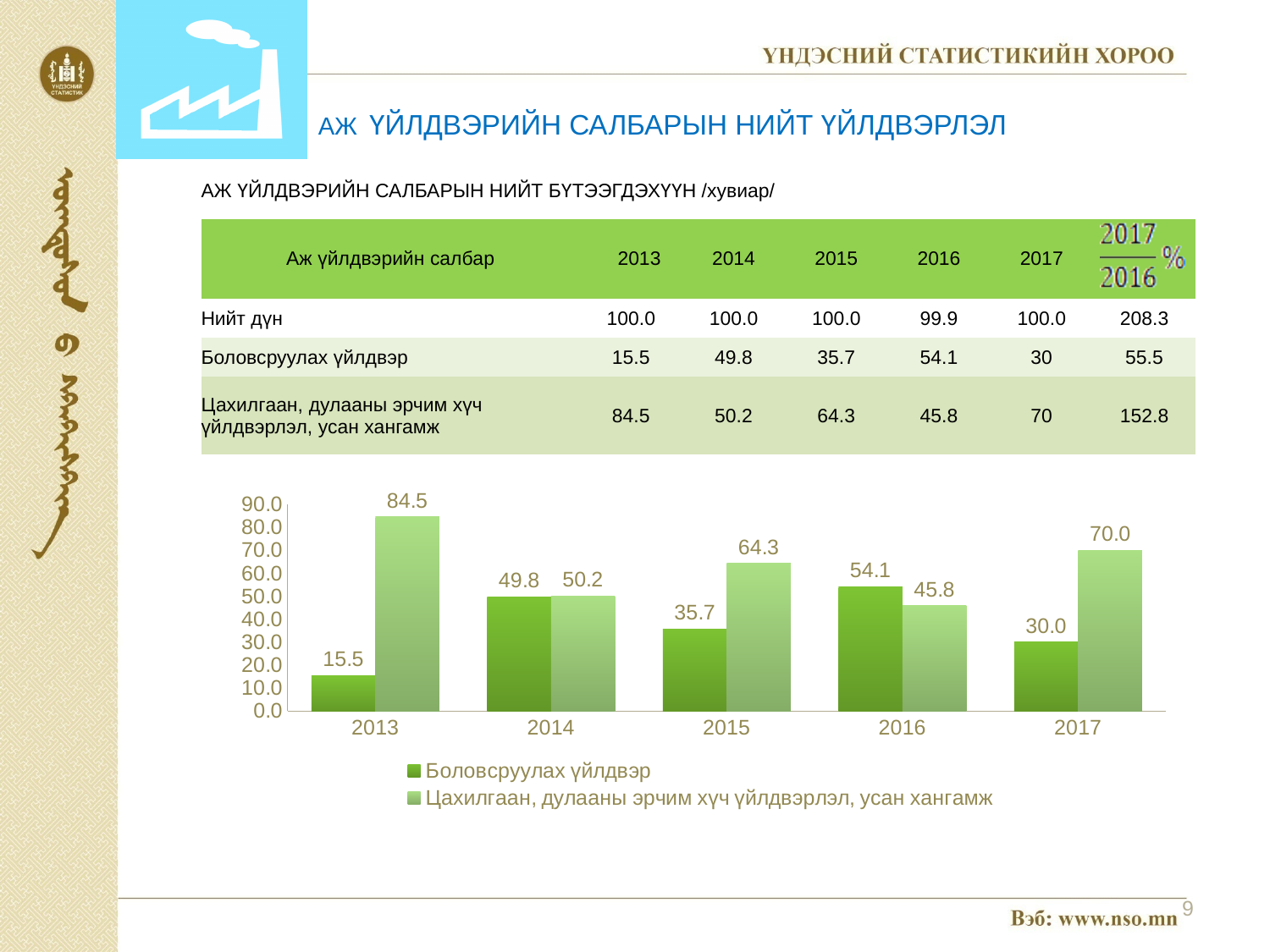
How many series does the chart legend list? 2 How many years are shown on the x axis of the chart? 5 In 2016, which series has the larger value? Боловсруулах үйлдвэр In which year is the value for Цахилгаан, дулааны эрчим хүч үйлдвэрлэл, усан хангамж lowest? 2016 What is the value for Цахилгаан, дулааны эрчим хүч үйлдвэрлэл, усан хангамж in 2015? 64.3 Is the value for Цахилгаан, дулааны эрчим хүч үйлдвэрлэл, усан хангамж in 2017 greater or less than 60.0? greater Which series is shown in the darker green colour in the chart? Боловсруулах үйлдвэр What type of chart is shown on the slide? bar chart What is the value for Боловсруулах үйлдвэр in 2013? 15.5 What is the value for Боловсруулах үйлдвэр in 2017? 30.0 What is the difference between the two series' values in 2013? 69.0 In which year is the value for Боловсруулах үйлдвэр highest? 2016